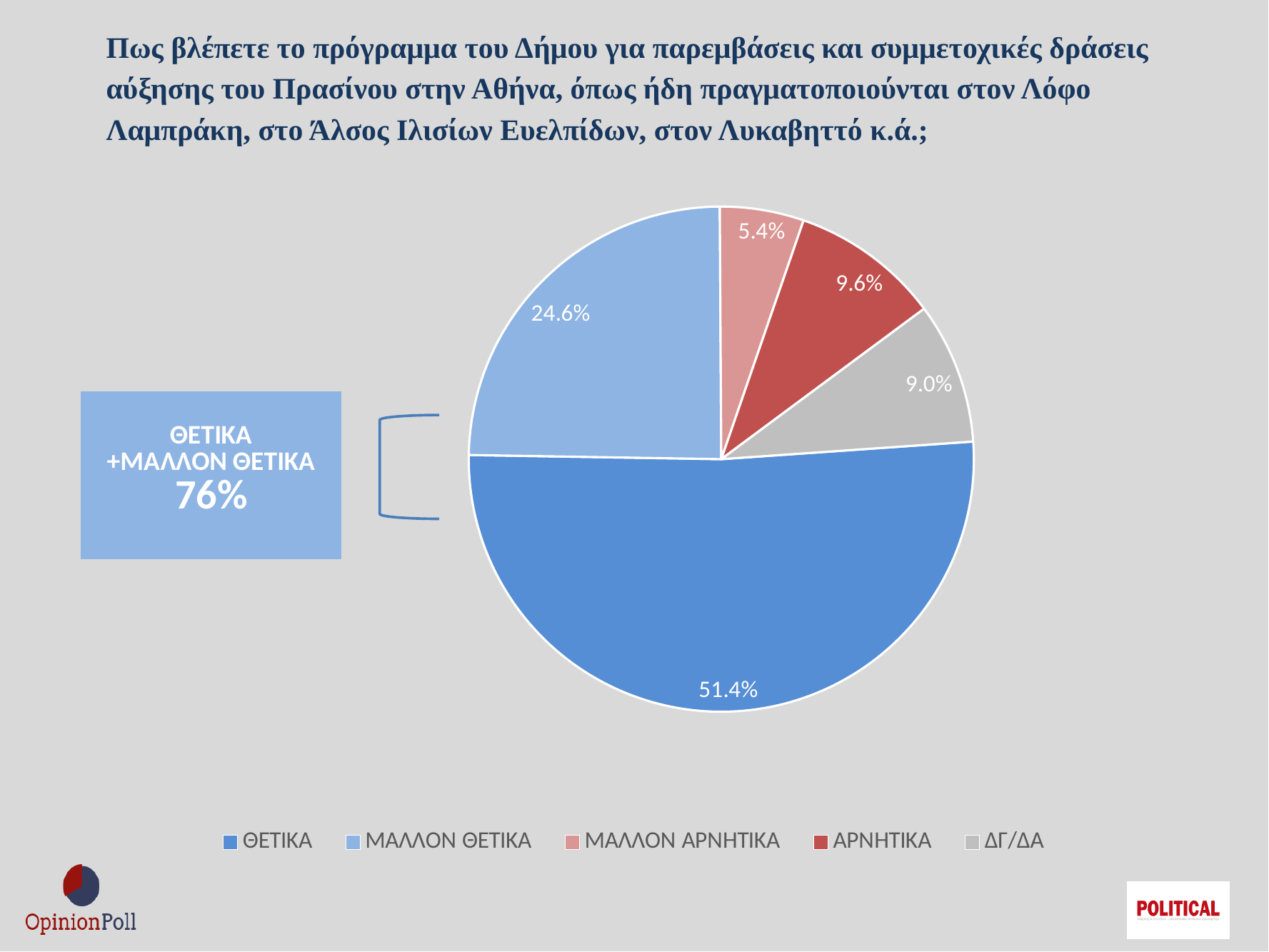
What percentage of respondents answered ΔΓ/ΔΑ? 9.0% Which response category has the largest share of the pie? ΘΕΤΙΚΑ What percentage of respondents answered ΜΑΛΛΟΝ ΑΡΝΗΤΙΚΑ? 5.4% How many categories does the legend list? 5 What combined percentage does the callout box give for ΘΕΤΙΚΑ + ΜΑΛΛΟΝ ΘΕΤΙΚΑ? 76% What percentage of respondents answered ΘΕΤΙΚΑ? 51.4% Which is larger, the share for ΑΡΝΗΤΙΚΑ or the share for ΜΑΛΛΟΝ ΑΡΝΗΤΙΚΑ? ΑΡΝΗΤΙΚΑ What is the difference in percentage points between ΘΕΤΙΚΑ and ΜΑΛΛΟΝ ΘΕΤΙΚΑ? 26.8 What type of chart is shown on the slide? pie chart Which response category has the smallest share of the pie? ΜΑΛΛΟΝ ΑΡΝΗΤΙΚΑ What percentage of respondents answered ΑΡΝΗΤΙΚΑ? 9.6% What percentage of respondents answered ΜΑΛΛΟΝ ΘΕΤΙΚΑ? 24.6%